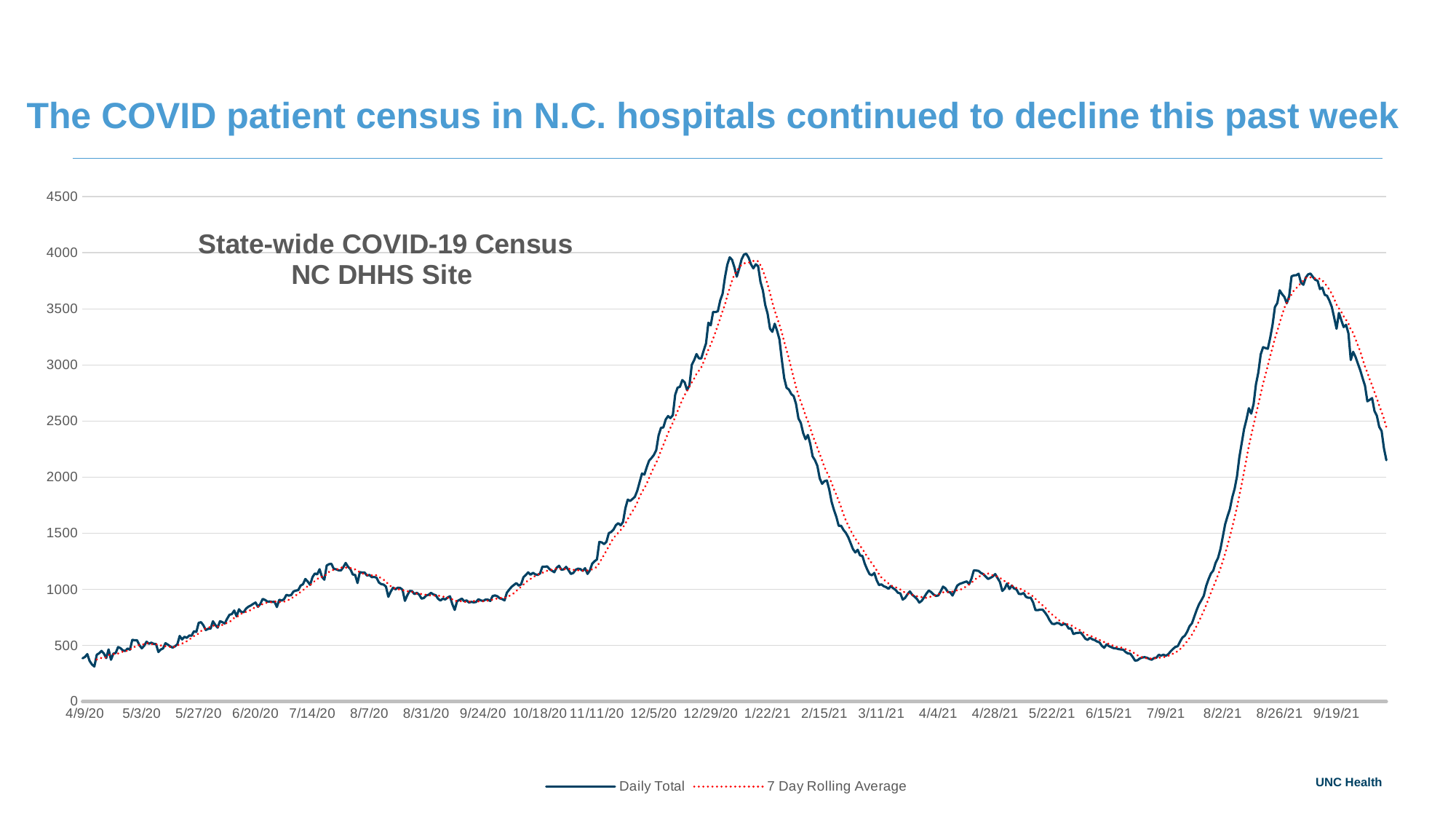
Is the Daily Total value at 7/9/21 greater or less than 1000? less Which is larger, the Daily Total at 12/29/20 or the Daily Total at 4/28/21? 12/29/20 What are the two series named in the chart legend? Daily Total and 7 Day Rolling Average Does the Daily Total rise or fall between 7/9/21 and 8/26/21? Rise Is the Daily Total value at 4/9/20 greater or less than 500? less Is the Daily Total value at 9/19/21 greater or less than 3000? greater Does the Daily Total rise or fall between 1/22/21 and 4/4/21? Fall How many series does the chart legend list? 2 What kind of chart is shown on the slide? Line chart What is the title printed inside the chart area? State-wide COVID-19 Census NC DHHS Site